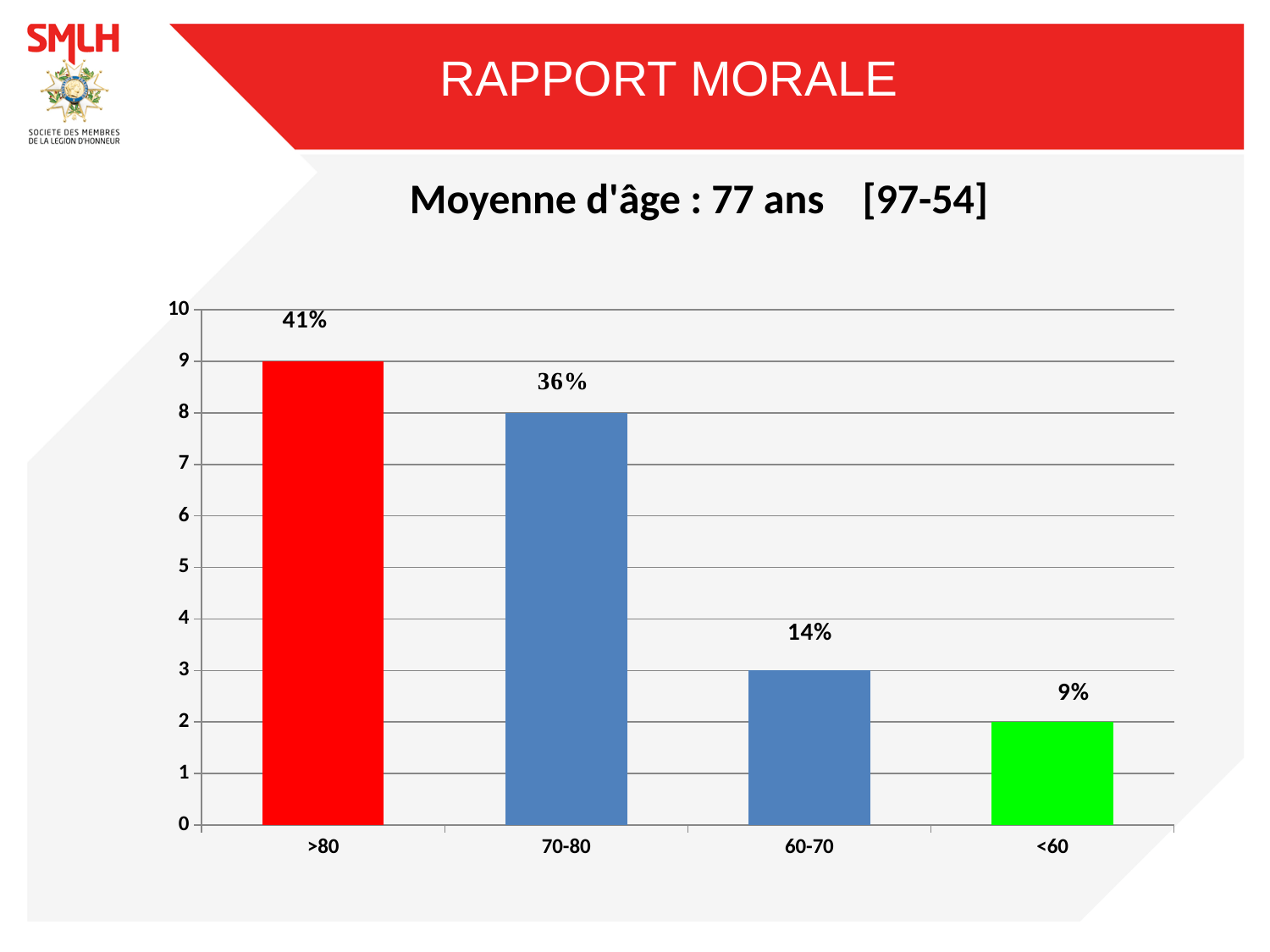
What percentage label is shown above the bar for <60? 9% What percentage label is shown above the bar for >80? 41% Which bar is taller, 70-80 or 60-70? 70-80 Which age category has the lowest bar? <60 What percentage label is shown above the bar for 60-70? 14% What kind of chart is shown on the slide? bar chart What colour is the bar for the <60 category? green Do the bar heights rise or fall from left to right along the x axis? fall What percentage label is shown above the bar for 70-80? 36% Which age category has the highest bar? >80 What is the difference between the percentage labels for >80 and 70-80? 5% How many age categories are shown on the x axis? 4